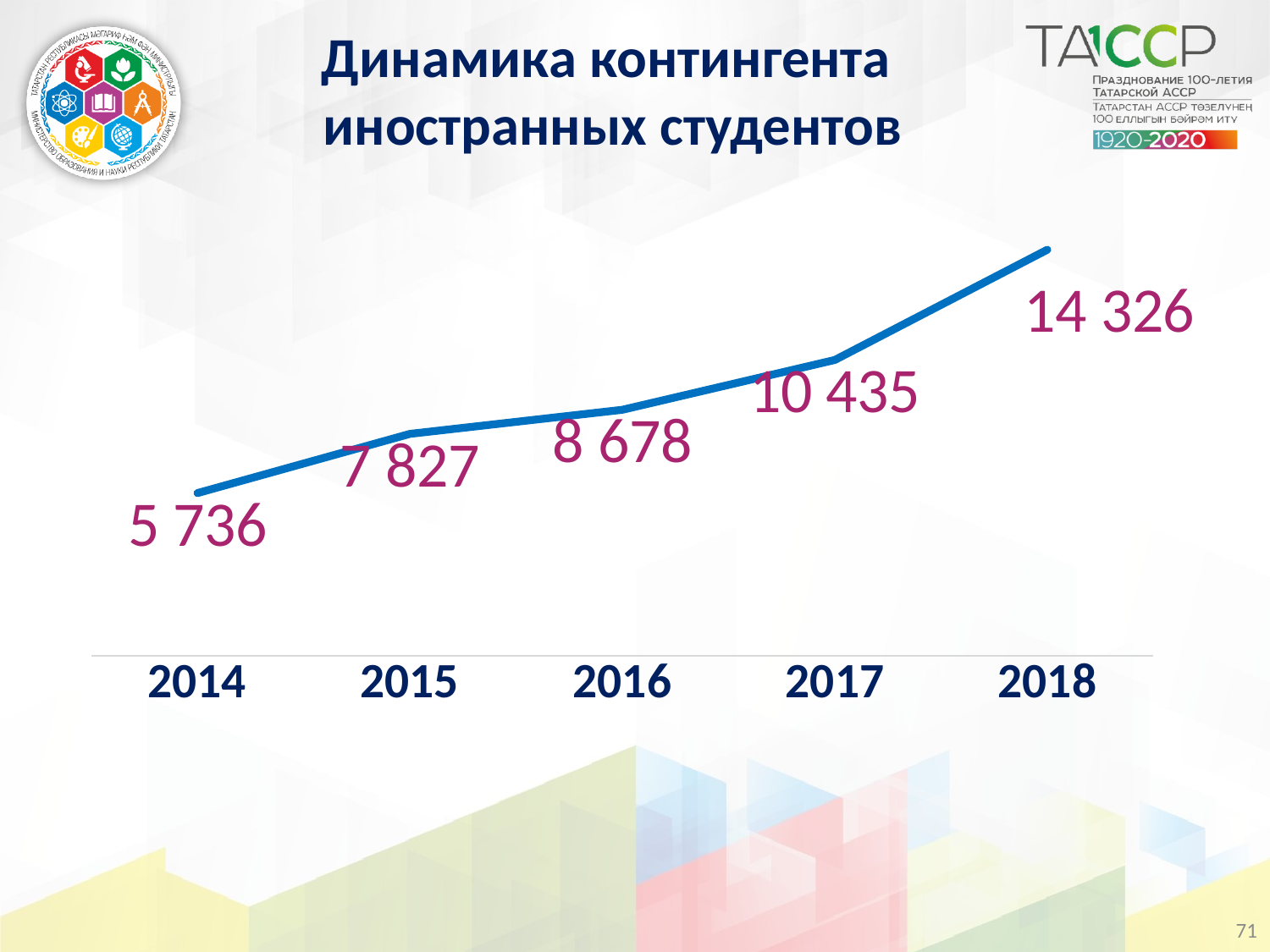
What is the title of the chart? Динамика контингента иностранных студентов What is the value for 2014? 5 736 Which is larger, the value for 2015 or the value for 2017? 2017 What is the value for 2018? 14 326 What is the value for 2016? 8 678 Which year has the lowest value? 2014 How many years are plotted on the chart? 5 What is the difference between the values for 2017 and 2016? 1 757 Do the values rise or fall from 2014 to 2018? rise What is the difference between the values for 2018 and 2014? 8 590 Which year has the highest value? 2018 What kind of chart is shown on the slide? line chart